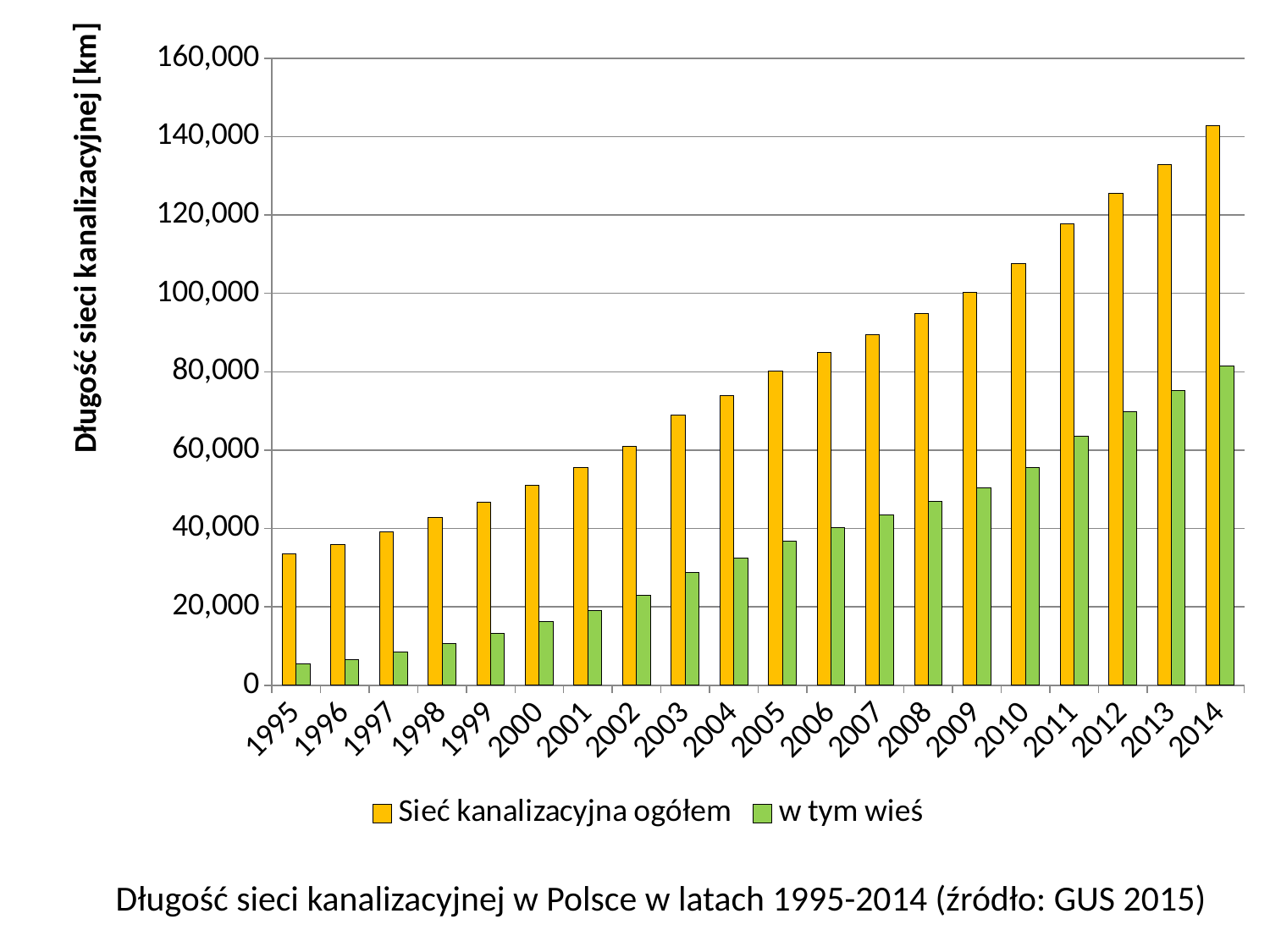
In 2014, which series has the larger value: 'Sieć kanalizacyjna ogółem' or 'w tym wieś'? Sieć kanalizacyjna ogółem How many series does the legend list? 2 Is the value for 'Sieć kanalizacyjna ogółem' in 2011 greater or less than 120,000? less What is the label of the y axis? Długość sieci kanalizacyjnej [km] Is the value for 'w tym wieś' in 1995 greater or less than 20,000? less Which year has the lowest value for 'w tym wieś'? 1995 What kind of chart is shown on the slide? bar chart Is the value for 'w tym wieś' in 2010 greater or less than 60,000? less How many years are shown on the x axis? 20 Do the values for 'Sieć kanalizacyjna ogółem' rise or fall from 1995 to 2014? rise Which year has the highest value for 'Sieć kanalizacyjna ogółem'? 2014